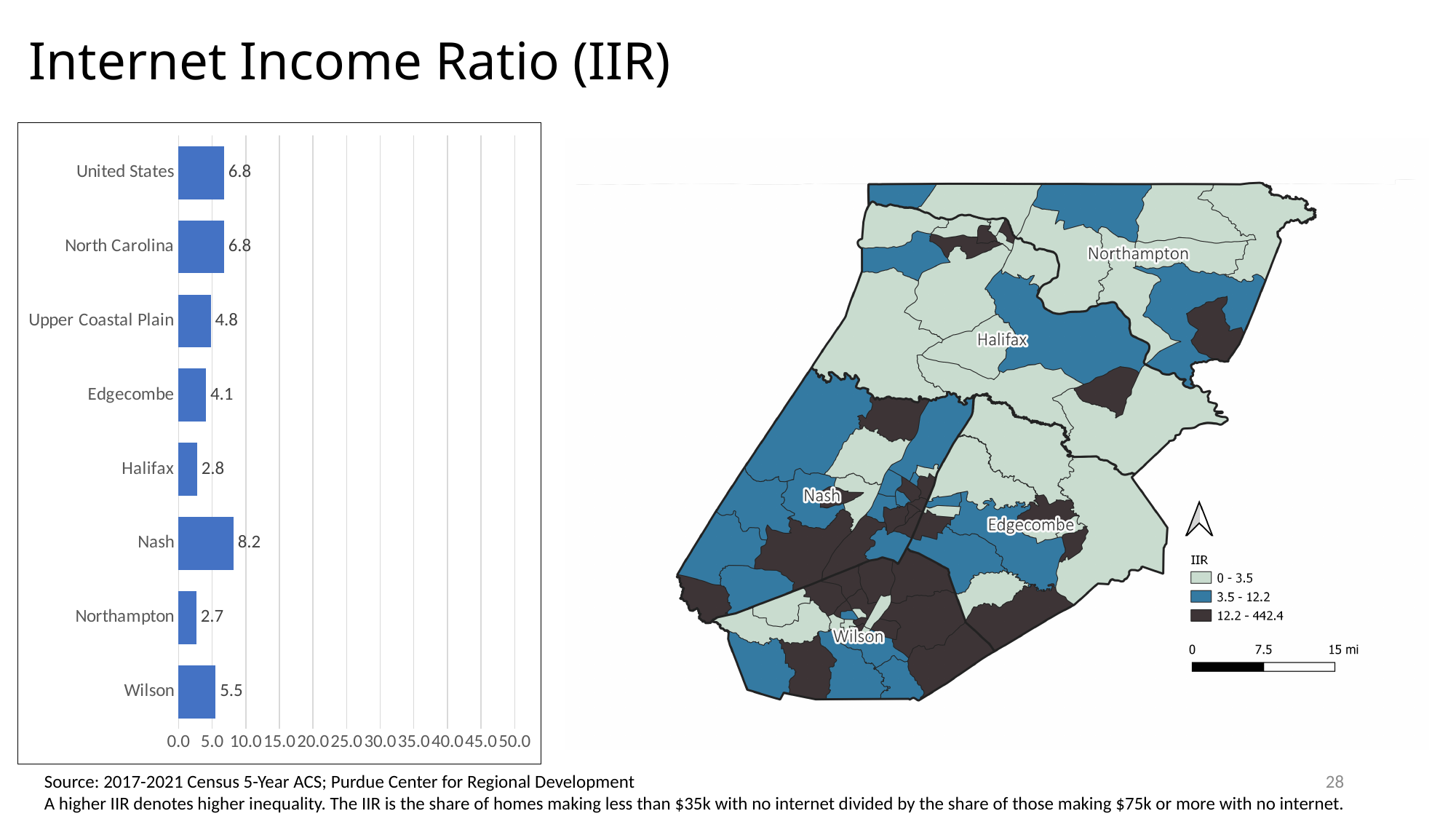
What is the Internet Income Ratio for the Upper Coastal Plain? 4.8 What is the difference between the Internet Income Ratio for Nash and for Halifax? 5.4 Is the Internet Income Ratio for Nash greater or less than 5.0? greater What is the difference between the Internet Income Ratio for the United States and for Edgecombe? 2.7 Which category has the lowest Internet Income Ratio? Northampton Which category has the highest Internet Income Ratio? Nash What is the Internet Income Ratio for Wilson? 5.5 Which has a higher Internet Income Ratio, Edgecombe or Wilson? Wilson What is the maximum value shown on the x axis of the bar chart? 50.0 What is the Internet Income Ratio for Nash? 8.2 What kind of chart is shown on the left of the slide? Bar chart How many categories are shown in the bar chart? 8